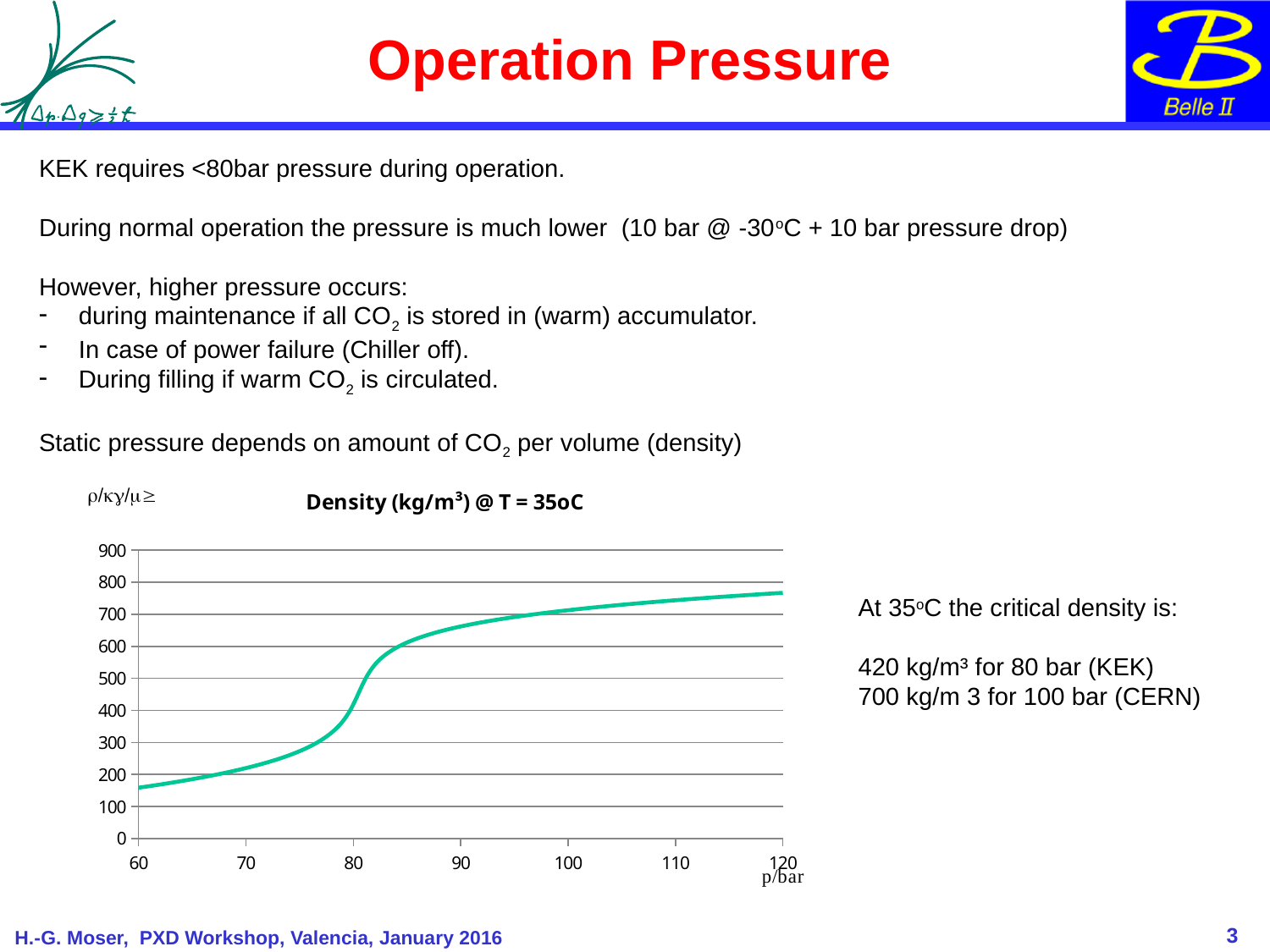
What is the label on the x axis of the chart? p/bar Is the density at 60 bar greater or less than 200? less Is the density at 90 bar greater or less than 600? greater At which pressure on the x axis is the plotted density highest? 120 What is the title of the chart? Density (kg/m³) @ T = 35oC Does the density rise or fall as pressure increases along the x axis? rise Which is larger, the density at 100 bar or the density at 70 bar? 100 bar Is the density at 110 bar greater or less than 800? less At which pressure on the x axis is the plotted density lowest? 60 What kind of chart is shown on the slide? line chart